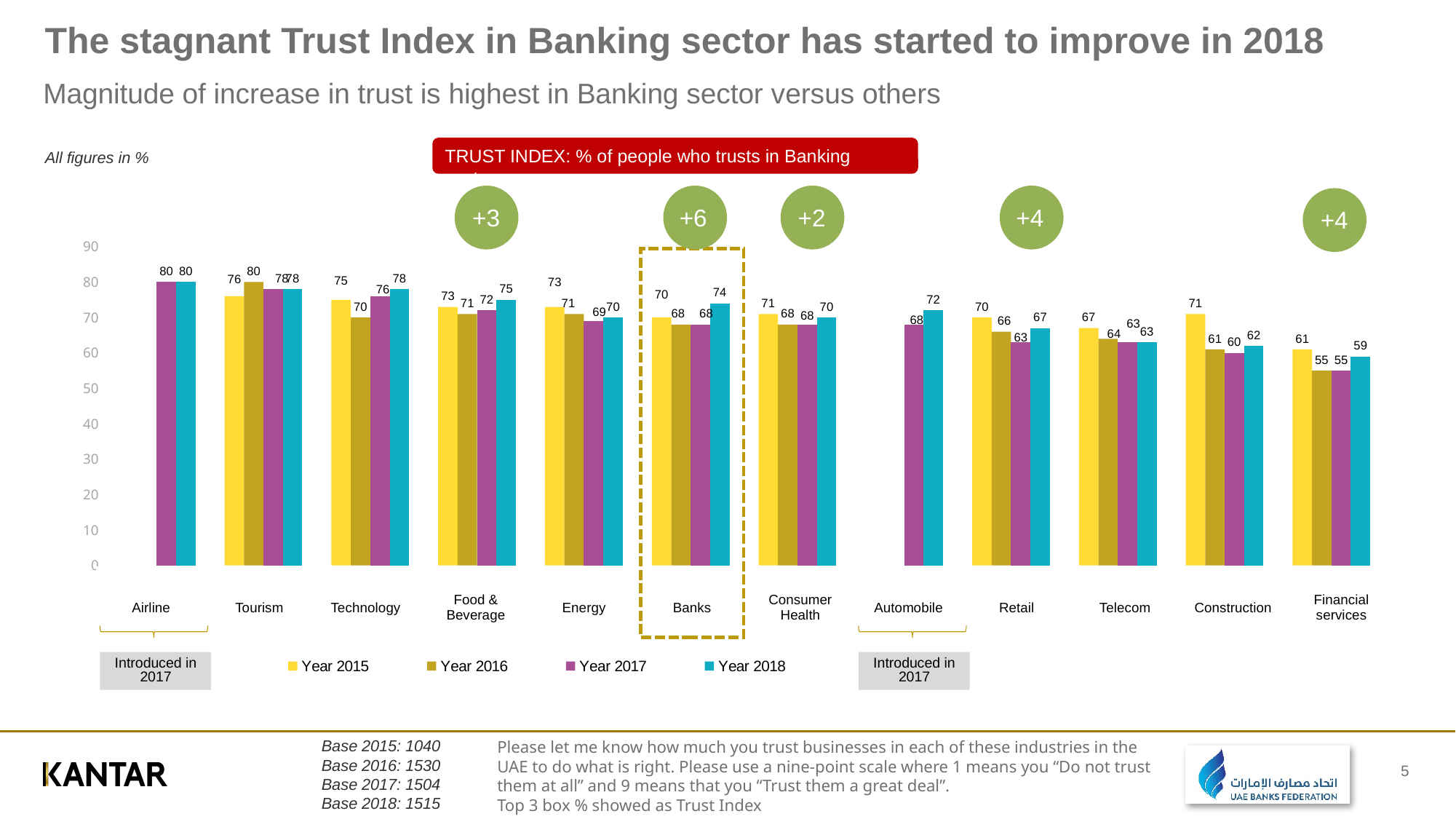
What is the Year 2018 value for Banks? 74 Which sector has the highest Year 2018 value? Airline Do the values for Telecom rise or fall from Year 2015 to Year 2018? Fall What is the Year 2016 value for Financial services? 55 What kind of chart is shown on the slide? Bar chart How many sectors are shown on the x axis of the chart? 12 How many series does the legend list? 4 What is the Year 2015 value for Construction? 71 What is the difference between the Year 2015 and Year 2017 values for Retail? 7 What is the difference between the Year 2018 and Year 2017 values for Banks? 6 Which sector has the lowest Year 2018 value? Financial services Which is larger: the Year 2018 value for Technology or the Year 2018 value for Energy? Technology